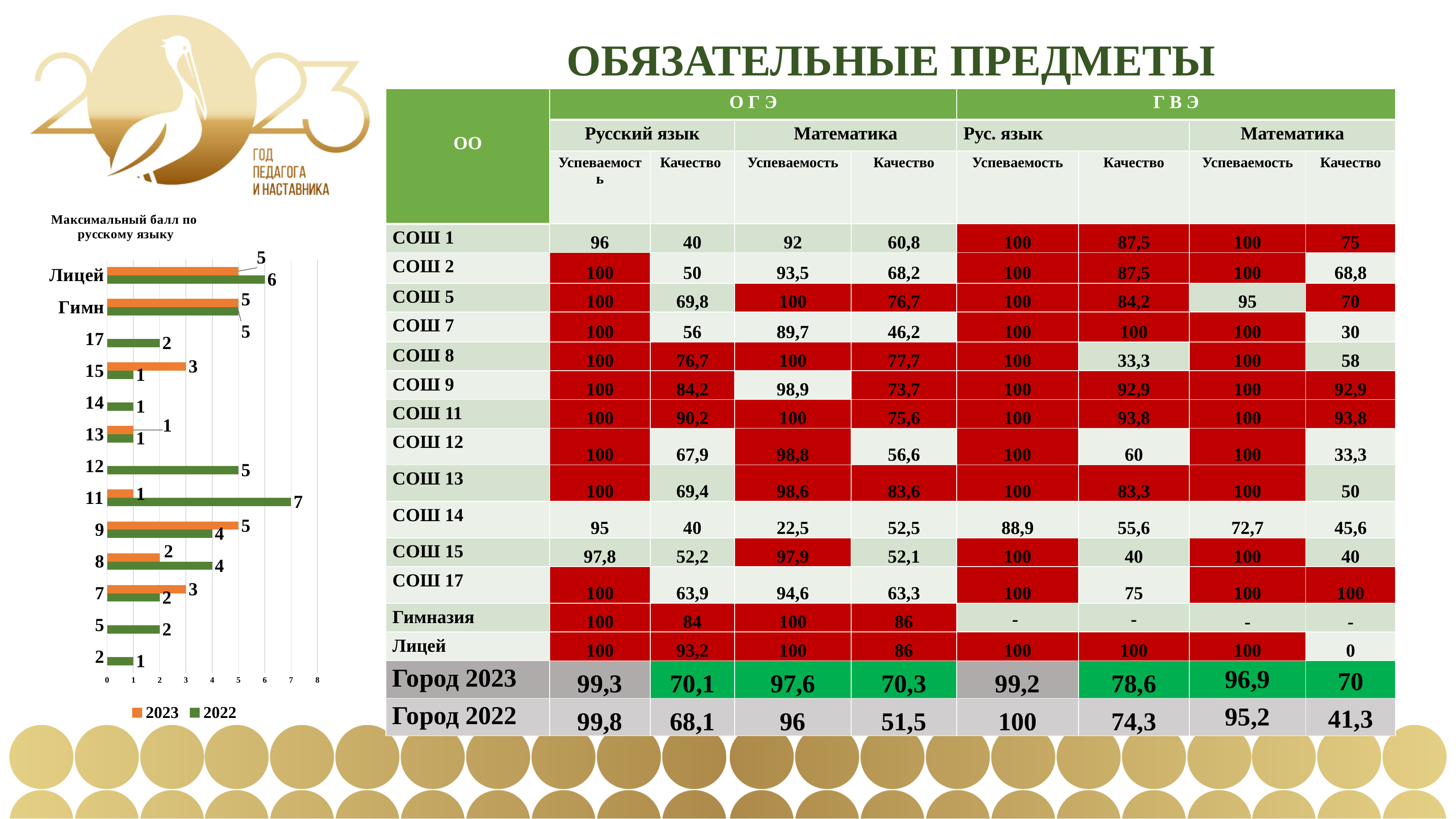
What type of chart is shown on the left of the slide under the title "Максимальный балл по русскому языку"? bar chart In the chart "Максимальный балл по русскому языку", what is the 2023 value for Лицей? 5 In the chart "Максимальный балл по русскому языку", what is the difference between the 2022 and 2023 values for category 11? 6 In the chart "Максимальный балл по русскому языку", what is the 2022 value for Лицей? 6 In the chart "Максимальный балл по русскому языку", how many categories are shown on the vertical axis? 13 In the chart "Максимальный балл по русскому языку", which is larger for category 8: the 2023 value or the 2022 value? 2022 In the chart "Максимальный балл по русскому языку", which category has the highest 2022 value? 11 In the chart "Максимальный балл по русскому языку", what is the difference between the 2022 and 2023 values for category 8? 2 In the chart "Максимальный балл по русскому языку", which colour represents the 2023 series? orange In the chart "Максимальный балл по русскому языку", what is the 2023 value for category 15? 3 In the chart "Максимальный балл по русскому языку", what is the 2022 value for category 11? 7 In the chart "Максимальный балл по русскому языку", how many series does the legend list? 2